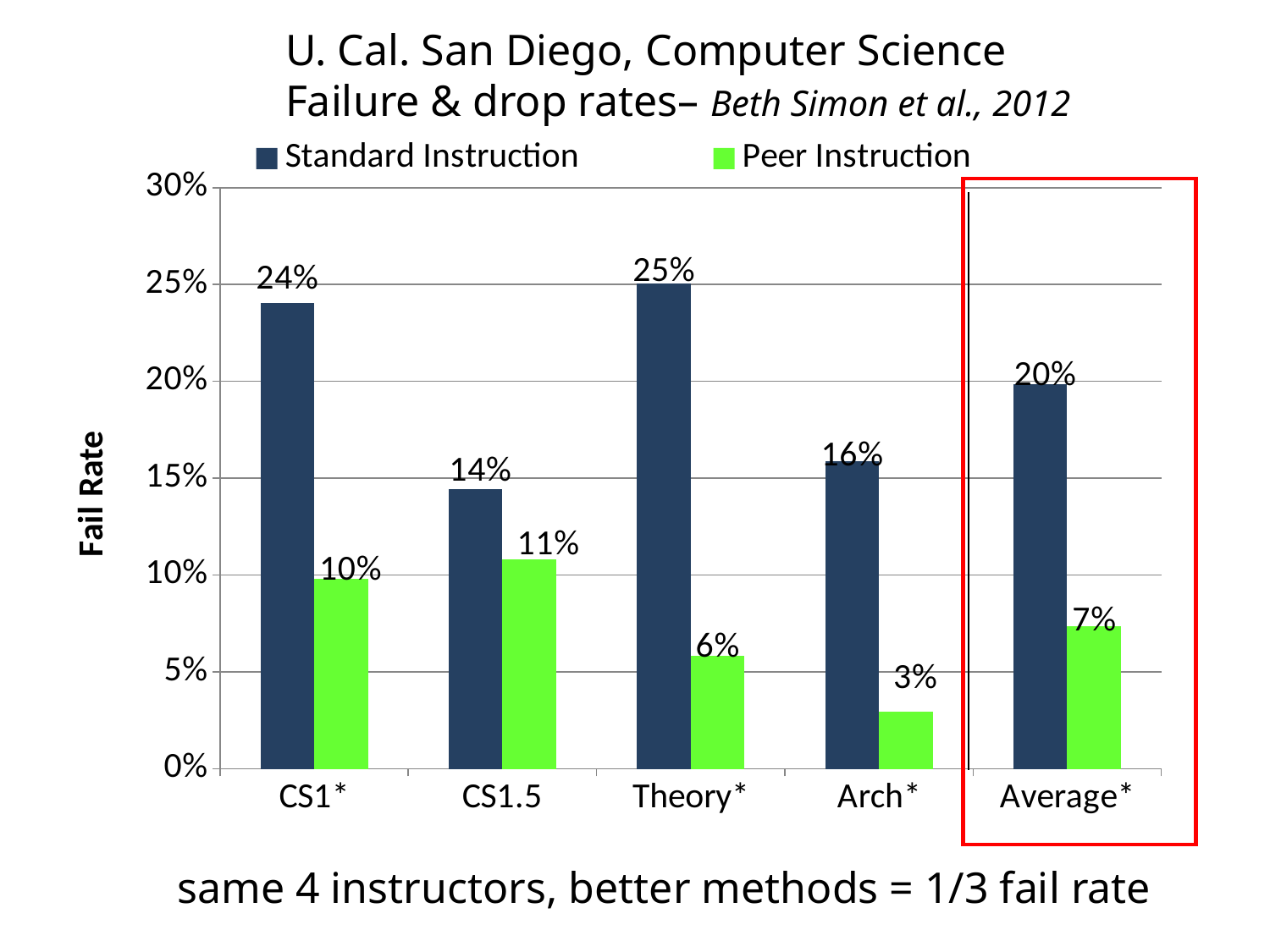
What is the label of the y axis? Fail Rate What is the difference between the Standard Instruction and Peer Instruction fail rates for Theory*? 19% What is the Peer Instruction fail rate for Arch*? 3% What is the Standard Instruction fail rate for CS1*? 24% Which is larger for CS1.5: the Standard Instruction fail rate or the Peer Instruction fail rate? Standard Instruction How many categories are shown on the x axis? 5 Is the Standard Instruction fail rate for Arch* greater or less than 20%? less How many series does the legend list? 2 Which category has the highest Standard Instruction fail rate? Theory* What kind of chart is shown on the slide? bar chart What is the Peer Instruction fail rate for Average*? 7% Which category has the lowest Peer Instruction fail rate? Arch*